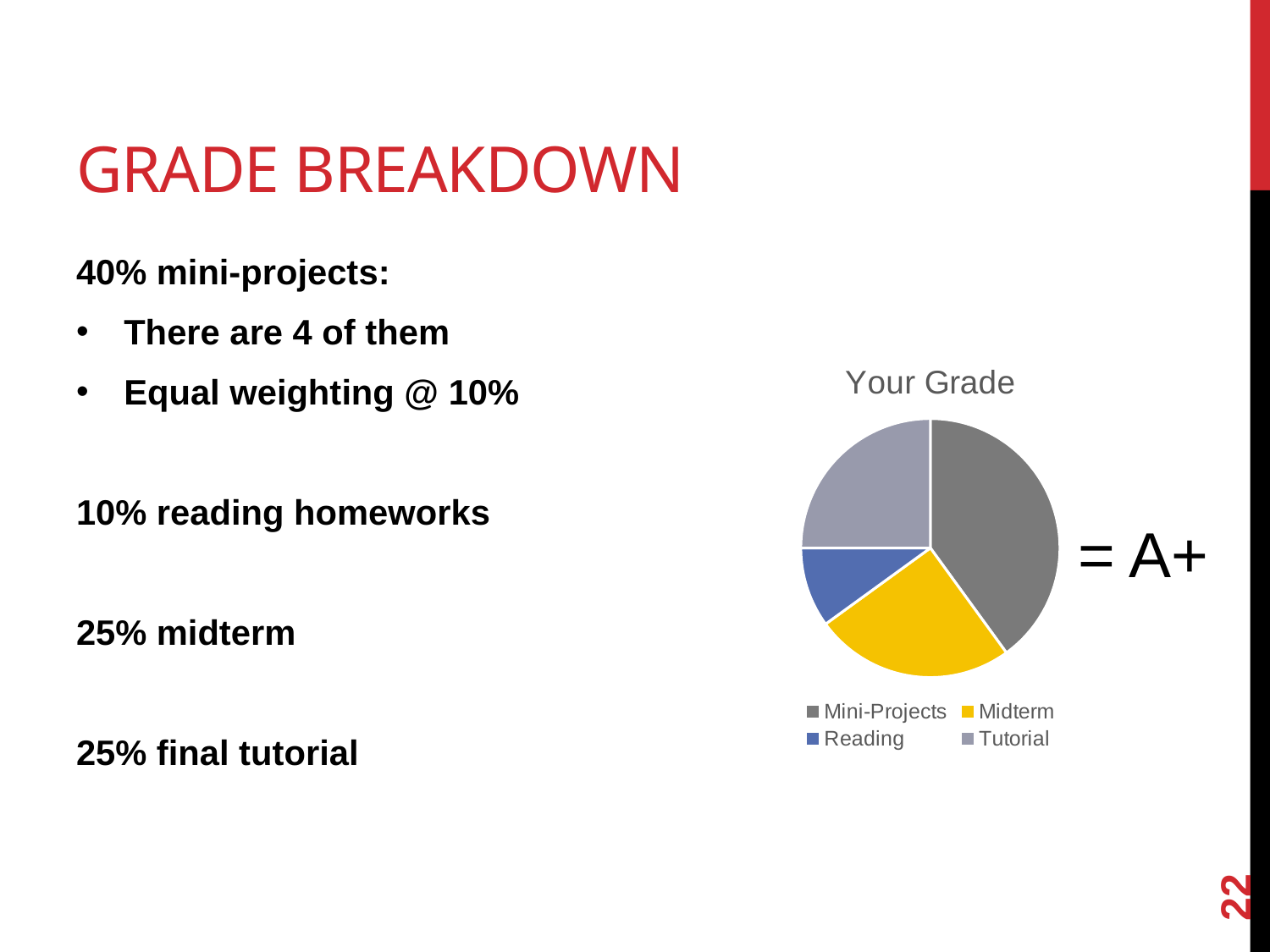
How many entries does the chart legend list? 4 How many slices does the pie chart have? 4 What share of the grade does the Midterm slice represent, according to the slide? 25% Which slice of the pie chart is the smallest? Reading Which is larger in the pie chart, the Mini-Projects slice or the Midterm slice? Mini-Projects What is the title of the chart? Your Grade Which slice of the pie chart is the largest? Mini-Projects What share of the grade does the Reading slice represent, according to the slide? 10% What kind of chart is shown on the slide? pie chart What share of the grade does the Mini-Projects slice represent, according to the slide? 40% What colour is the Midterm slice in the pie chart? yellow Which is larger in the pie chart, the Reading slice or the Tutorial slice? Tutorial